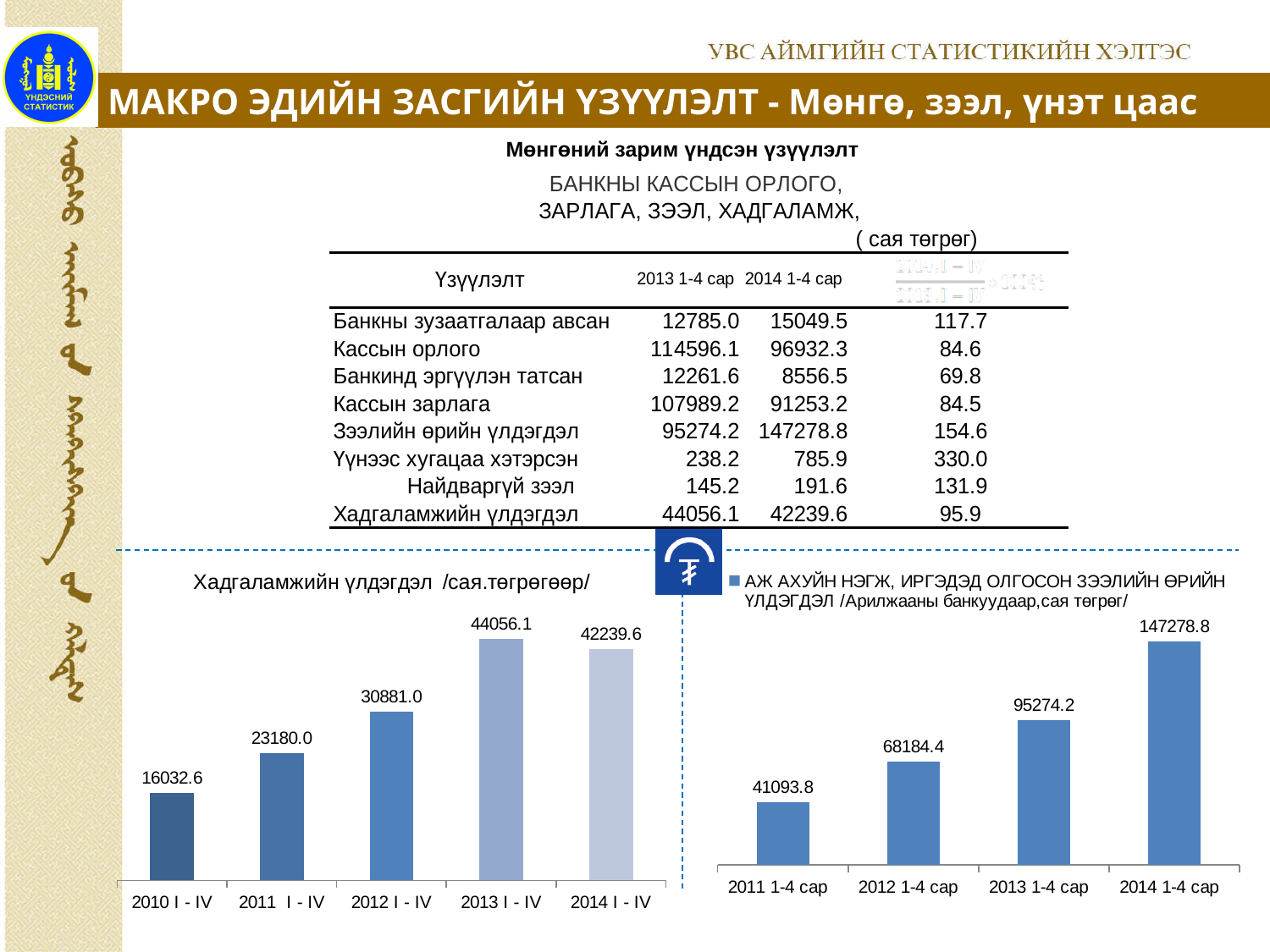
In the right chart (зээлийн өрийн үлдэгдэл), which category has the lowest value? 2011 1-4 сар In the left chart (Хадгаламжийн үлдэгдэл), what is the difference between the values for 2013 I - IV and 2014 I - IV? 1816.5 In the left chart (Хадгаламжийн үлдэгдэл), which category has the highest value? 2013 I - IV In the right chart (зээлийн өрийн үлдэгдэл), what is the difference between the values for 2014 1-4 сар and 2013 1-4 сар? 52004.6 What kind of chart is the right chart (зээлийн өрийн үлдэгдэл)? bar chart In the left chart (Хадгаламжийн үлдэгдэл), what is the value for 2010 I - IV? 16032.6 In the left chart (Хадгаламжийн үлдэгдэл), which category has the lowest value? 2010 I - IV In the left chart (Хадгаламжийн үлдэгдэл), how many bars are plotted? 5 In the right chart (зээлийн өрийн үлдэгдэл), what is the value for 2012 1-4 сар? 68184.4 In the right chart (зээлийн өрийн үлдэгдэл), do the values rise or fall from 2011 1-4 сар to 2014 1-4 сар? rise In the right chart (зээлийн өрийн үлдэгдэл), what is the value for 2014 1-4 сар? 147278.8 In the left chart (Хадгаламжийн үлдэгдэл), what is the value for 2012 I - IV? 30881.0